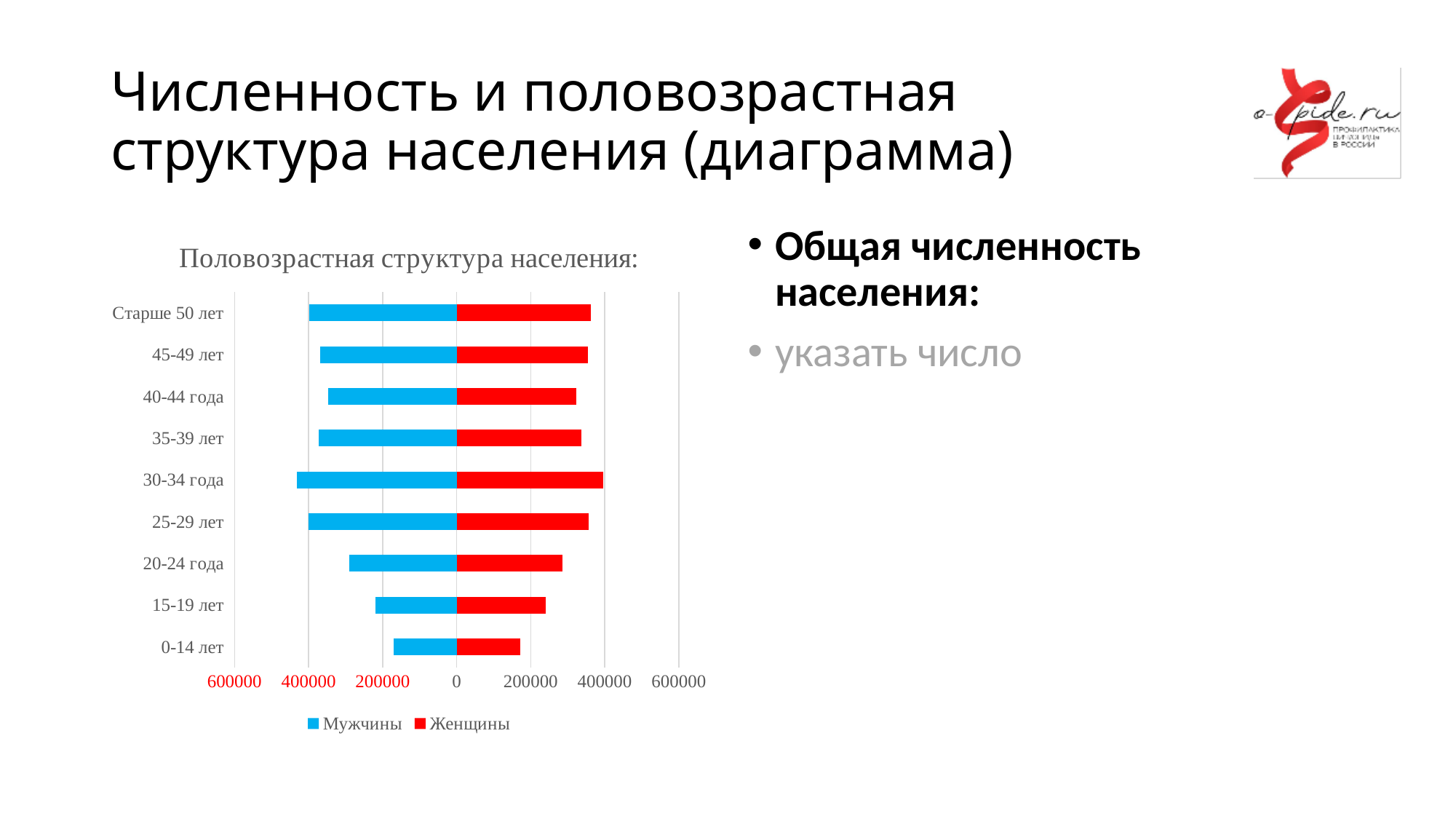
Which age group has the largest value for Женщины? 30-34 года Is the value for Женщины in the 0-14 лет group greater or less than 200000? less Which age group has the smallest value for Мужчины? 0-14 лет Is the value for Мужчины in the 30-34 года group greater or less than 400000? greater What kind of chart is shown on the slide? bar chart Which age group has the smallest value for Женщины? 0-14 лет How many series does the chart legend list? 2 How many age groups are shown on the chart? 9 Which colour represents the Мужчины series? blue What is the title of the chart? Половозрастная структура населения: Which is larger for Мужчины: the 30-34 года group or the 20-24 года group? 30-34 года Which age group has the largest value for Мужчины? 30-34 года